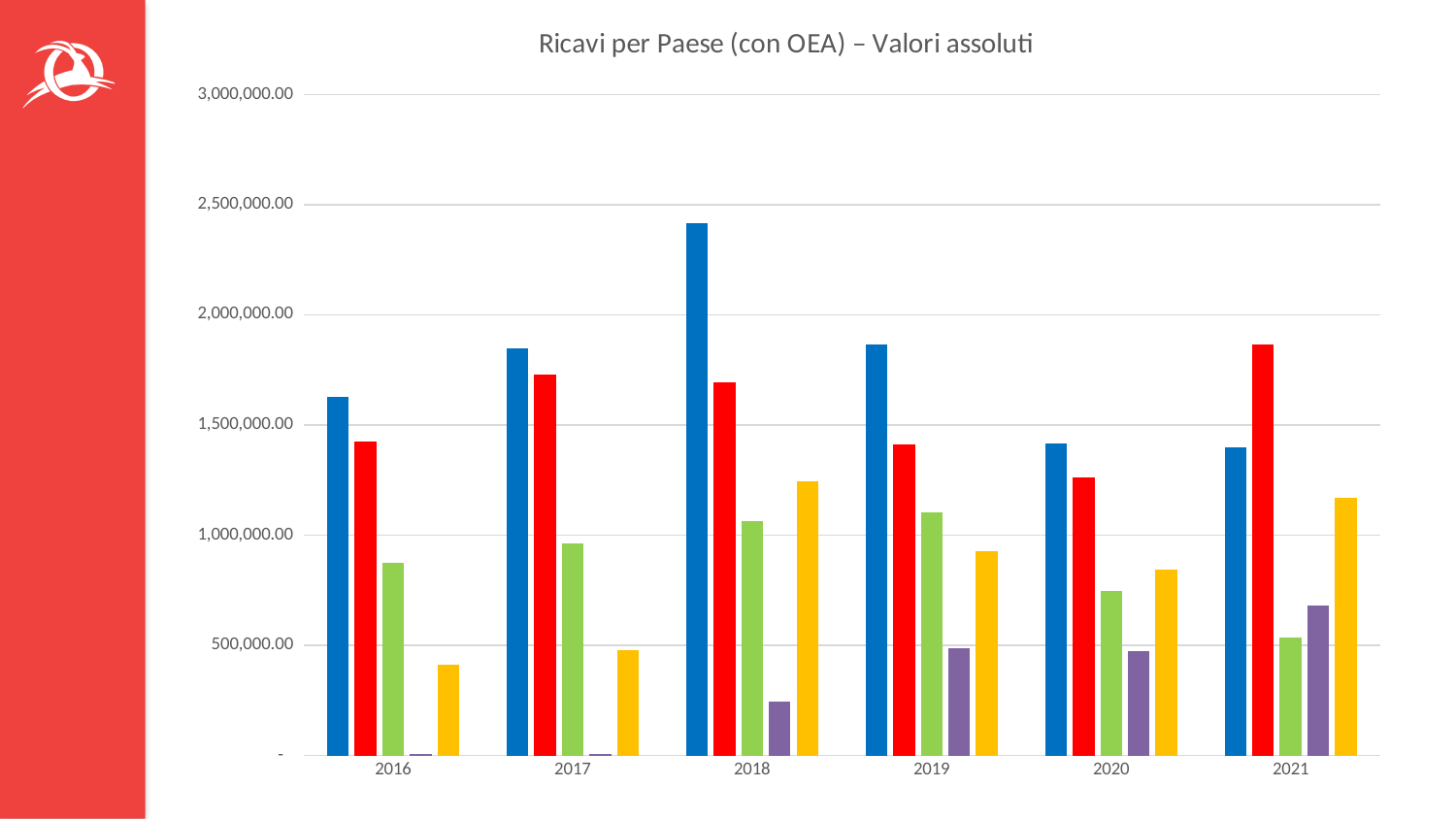
Is the value of the red bar for 2020 greater or less than 1,500,000.00? less What kind of chart is shown on the slide? bar chart Do the purple bars rise or fall from 2016 to 2019? rise In which year is the blue bar the tallest? 2018 For 2021, which bar is taller, the red bar or the blue bar? red Is the value of the blue bar for 2018 greater or less than 2,000,000.00? greater What is the title of the chart? Ricavi per Paese (con OEA) – Valori assoluti In which year is the purple bar the tallest? 2021 Is the value of the yellow bar for 2016 greater or less than 500,000.00? less How many years are shown on the x axis of the chart? 6 How many bars are plotted for each year in the chart? 5